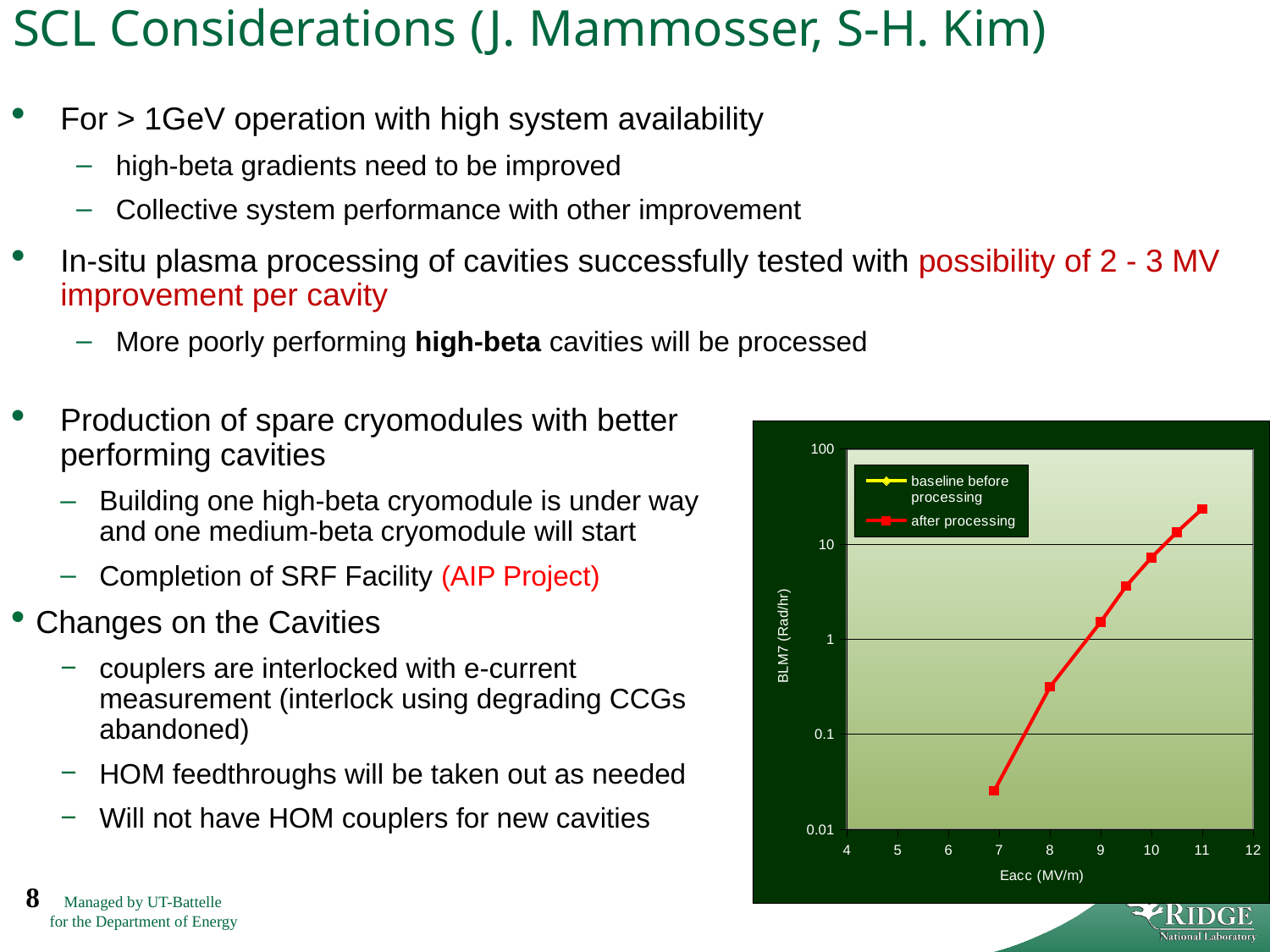
Is the 'after processing' value at Eacc = 8 MV/m greater or less than 1? less How many series does the chart's legend list? 2 Is the lowest plotted 'after processing' value (near Eacc = 7 MV/m) greater or less than 0.1? less What kind of chart is shown on the slide? line chart Which has the larger 'after processing' value: Eacc = 11 MV/m or Eacc = 8 MV/m? Eacc = 11 MV/m What is the label of the chart's y axis? BLM7 (Rad/hr) What are the two series named in the chart's legend? baseline before processing; after processing Does the 'after processing' series rise or fall as Eacc (MV/m) increases? rise Is the 'after processing' value at Eacc = 10 MV/m greater or less than 1? greater How many data points are plotted for the 'after processing' series? 7 At which Eacc value does the 'after processing' series reach its highest plotted point? 11